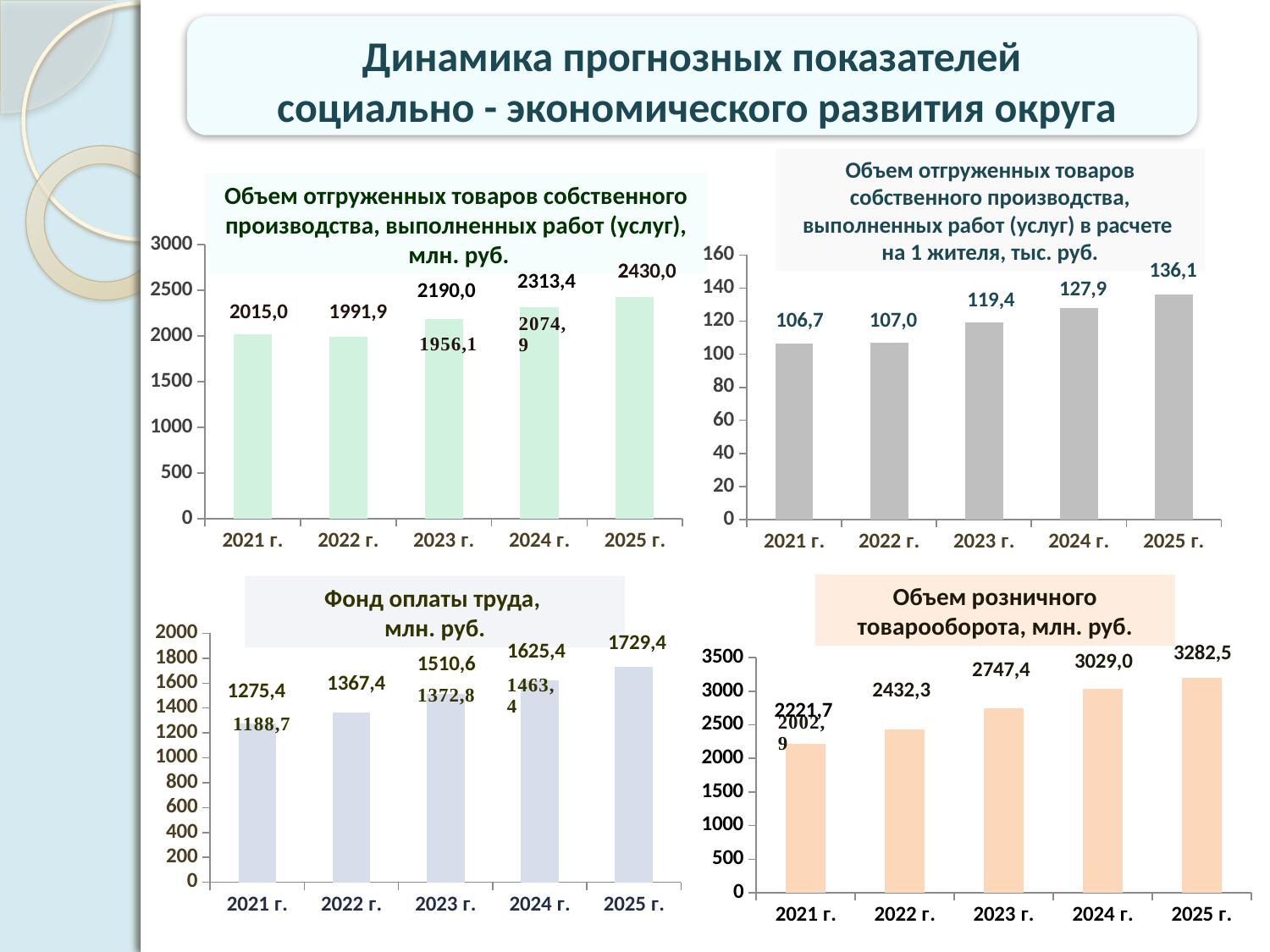
In the chart 'Фонд оплаты труда, млн. руб.', which is larger: the value for 2024 г. or 2023 г.? 2024 г. In the chart 'Объем розничного товарооборота, млн. руб.', do the values rise or fall from 2021 г. to 2025 г.? rise In the chart 'Объем розничного товарооборота, млн. руб.', what is the difference between the 2025 г. and 2021 г. values? 1060,8 In the chart 'Объем отгруженных товаров собственного производства, выполненных работ (услуг) в расчете на 1 жителя, тыс. руб.', what is the difference between the 2025 г. and 2021 г. values? 29,4 In the chart 'Объем отгруженных товаров собственного производства, выполненных работ (услуг), млн. руб.', which year has the highest value? 2025 г. In the chart 'Объем отгруженных товаров собственного производства, выполненных работ (услуг) в расчете на 1 жителя, тыс. руб.', what is the value for 2025 г.? 136,1 What kind of chart is 'Объем розничного товарооборота, млн. руб.'? bar chart How many years are shown on the x axis of the chart 'Фонд оплаты труда, млн. руб.'? 5 In the chart 'Фонд оплаты труда, млн. руб.', what is the value for 2022 г.? 1367,4 In the chart 'Объем розничного товарооборота, млн. руб.', what is the value for 2023 г.? 2747,4 In the chart 'Объем отгруженных товаров собственного производства, выполненных работ (услуг) в расчете на 1 жителя, тыс. руб.', which year has the lowest value? 2021 г. In the chart 'Объем розничного товарооборота, млн. руб.', is the value for 2024 г. greater or less than 3000? greater